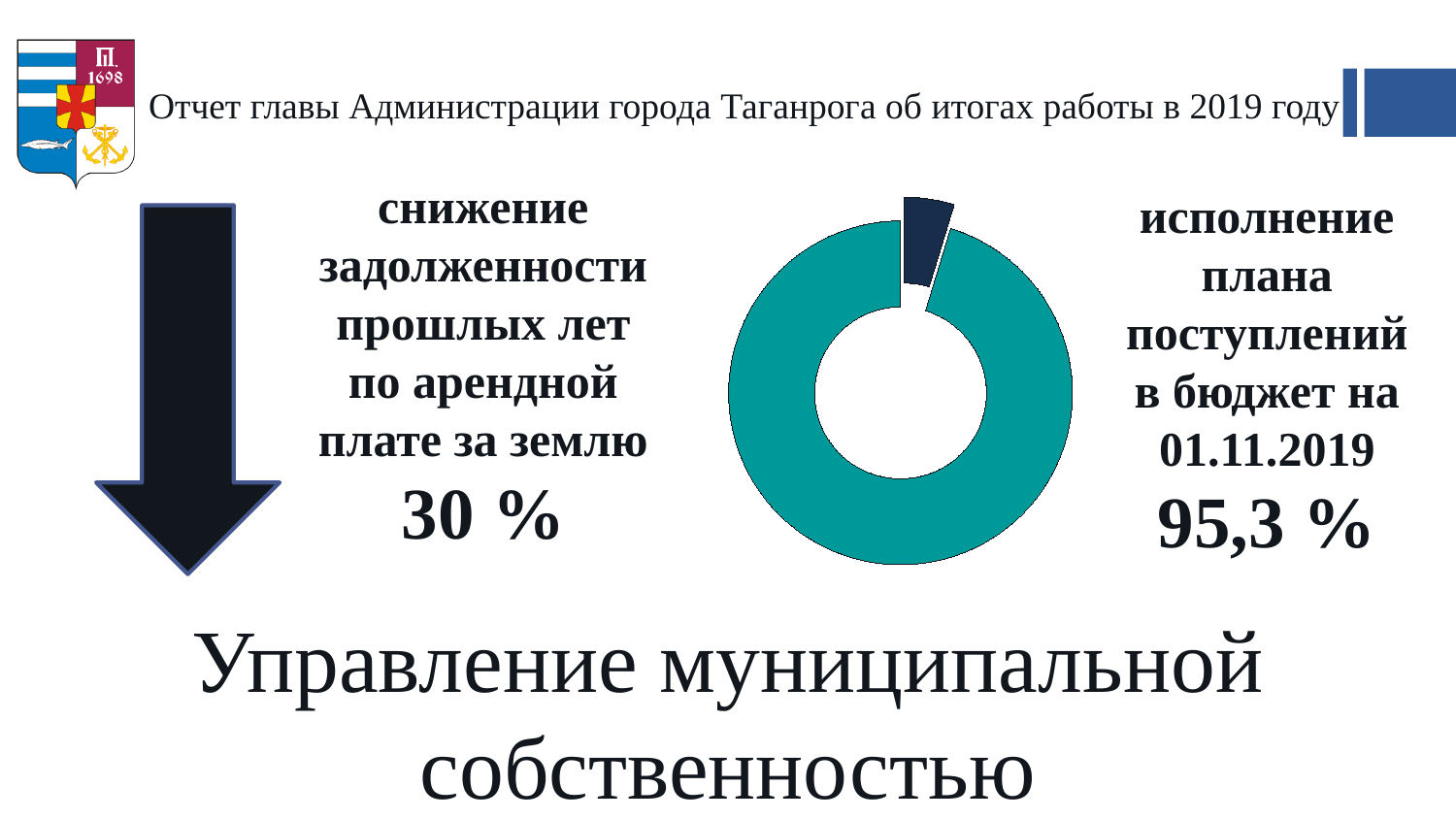
How many slices does the doughnut chart have? 2 Which slice of the doughnut chart is pulled out (exploded) from the ring? the dark navy slice What kind of chart is shown on the slide? doughnut chart Which slice of the doughnut chart is the smallest? the dark navy slice Which slice of the doughnut chart is larger, the teal one or the dark navy one? the teal one Is the share of the teal slice in the doughnut chart greater or less than 50%? greater According to the text next to the doughnut chart, what share of the budget revenue plan was fulfilled as of 01.11.2019? 95,3 % What colour is the largest slice of the doughnut chart? teal Is the share of the dark navy slice in the doughnut chart greater or less than 25%? less What date does the text next to the doughnut chart give for the plan fulfilment figure? 01.11.2019